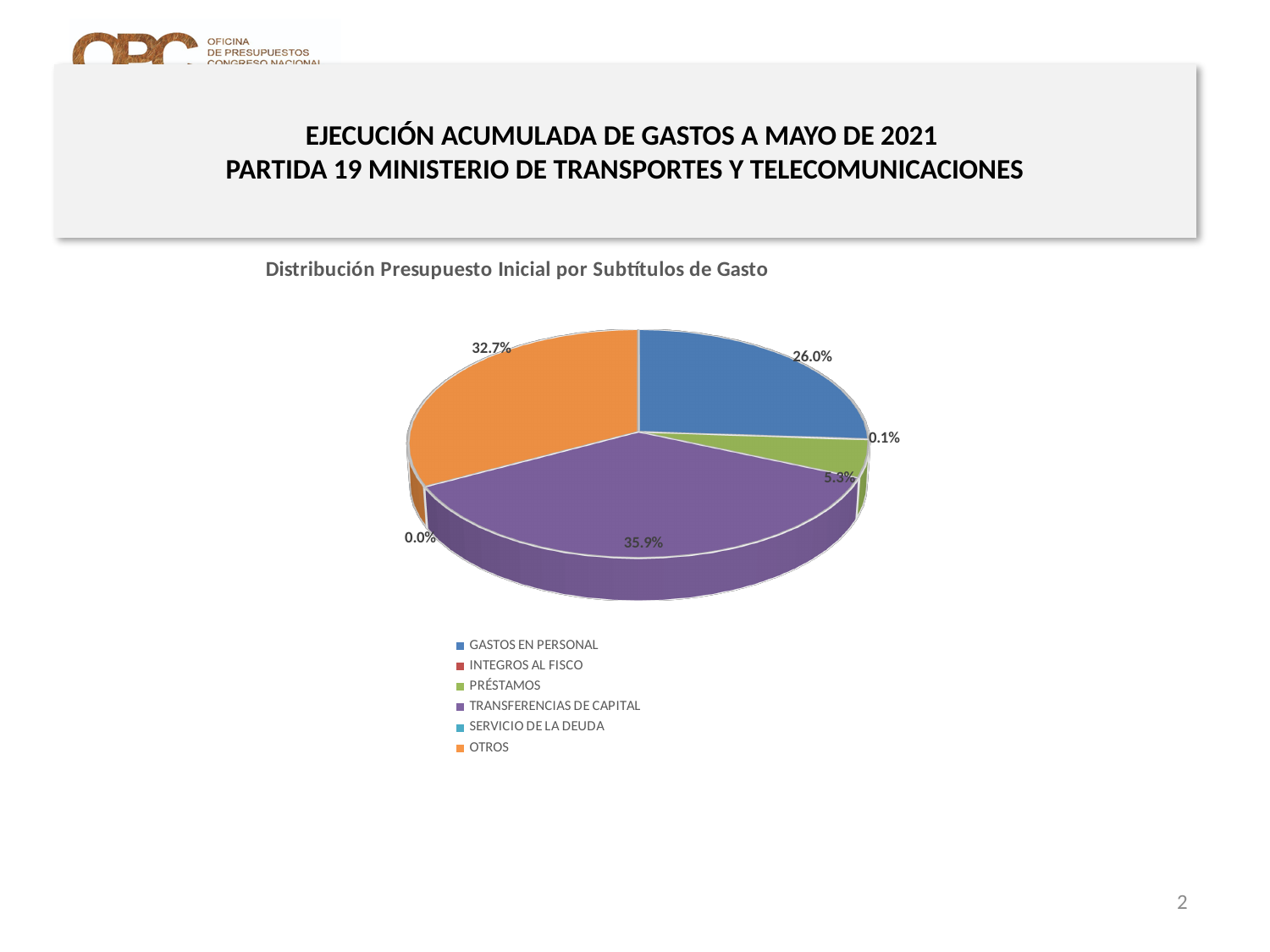
What share of the pie does GASTOS EN PERSONAL represent? 26.0% How many categories does the legend list? 6 Which category has the largest share of the pie? TRANSFERENCIAS DE CAPITAL What type of chart is shown on the slide? Pie chart Which is larger, the share for GASTOS EN PERSONAL or the share for PRÉSTAMOS? GASTOS EN PERSONAL What share of the pie does OTROS represent? 32.7% What is the title of the chart? Distribución Presupuesto Inicial por Subtítulos de Gasto Which category has the smallest share of the pie? SERVICIO DE LA DEUDA What share of the pie does PRÉSTAMOS represent? 5.3% What share of the pie does TRANSFERENCIAS DE CAPITAL represent? 35.9% What share of the pie does SERVICIO DE LA DEUDA represent? 0.0% What is the difference in percentage points between TRANSFERENCIAS DE CAPITAL and OTROS? 3.2